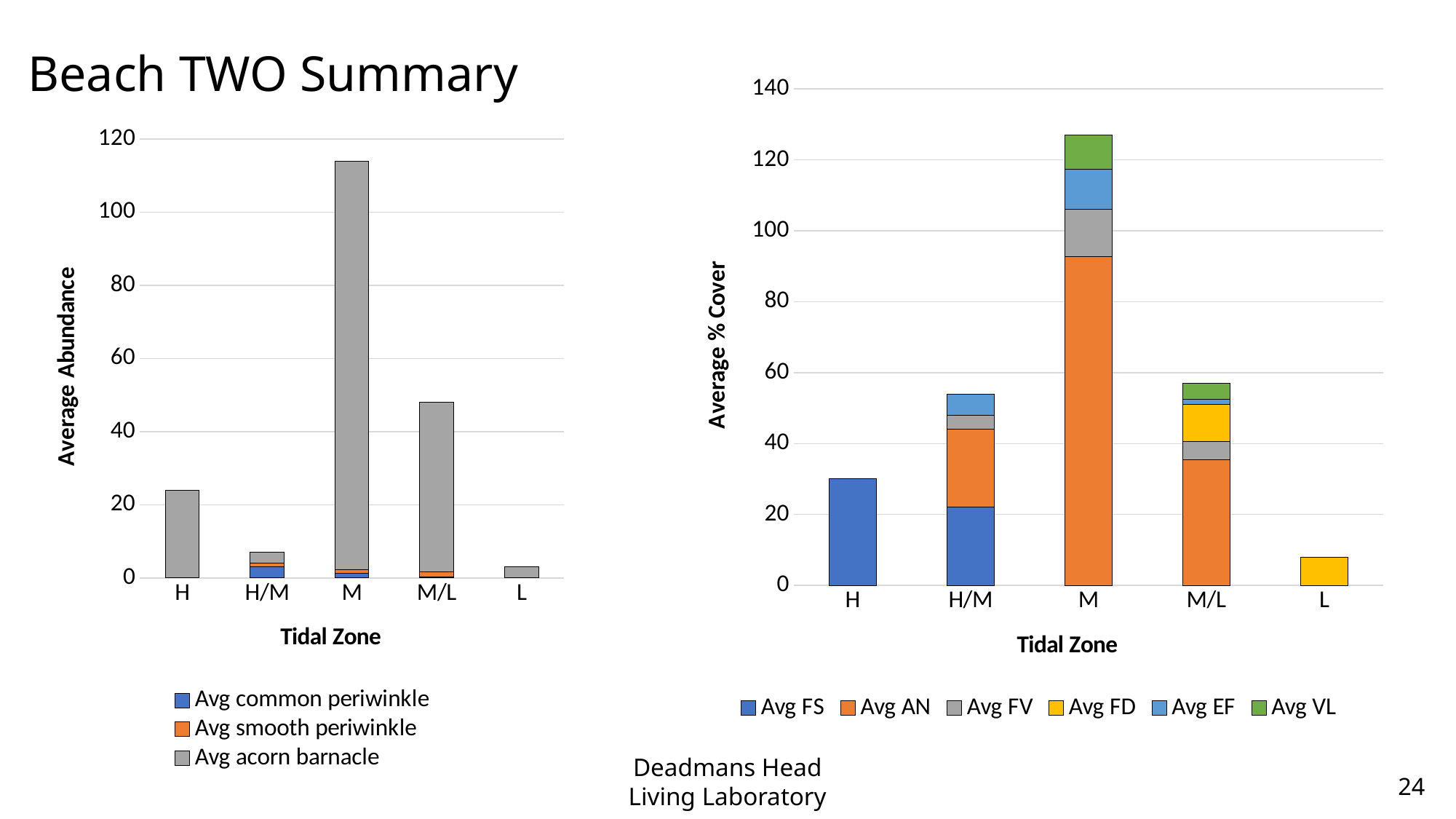
On the left chart (Average Abundance), is the total value for M/L greater or less than 40? greater On the left chart (Average Abundance), how many tidal zone categories are shown on the x axis? 5 On the left chart (Average Abundance), which tidal zone has the highest total bar? M On the right chart (Average % Cover), which tidal zone has the highest total bar? M On the left chart (Average Abundance), is the total value for M greater or less than 100? greater On the left chart (Average Abundance), which tidal zone has the lowest total bar? L What kind of chart is the right chart (Average % Cover)? Stacked bar chart On the right chart (Average % Cover), how many series does the legend list? 6 On the right chart (Average % Cover), is the total value for M greater or less than 120? greater On the left chart (Average Abundance), how many series does the legend list? 3 On the right chart (Average % Cover), which tidal zone has the lowest total bar? L